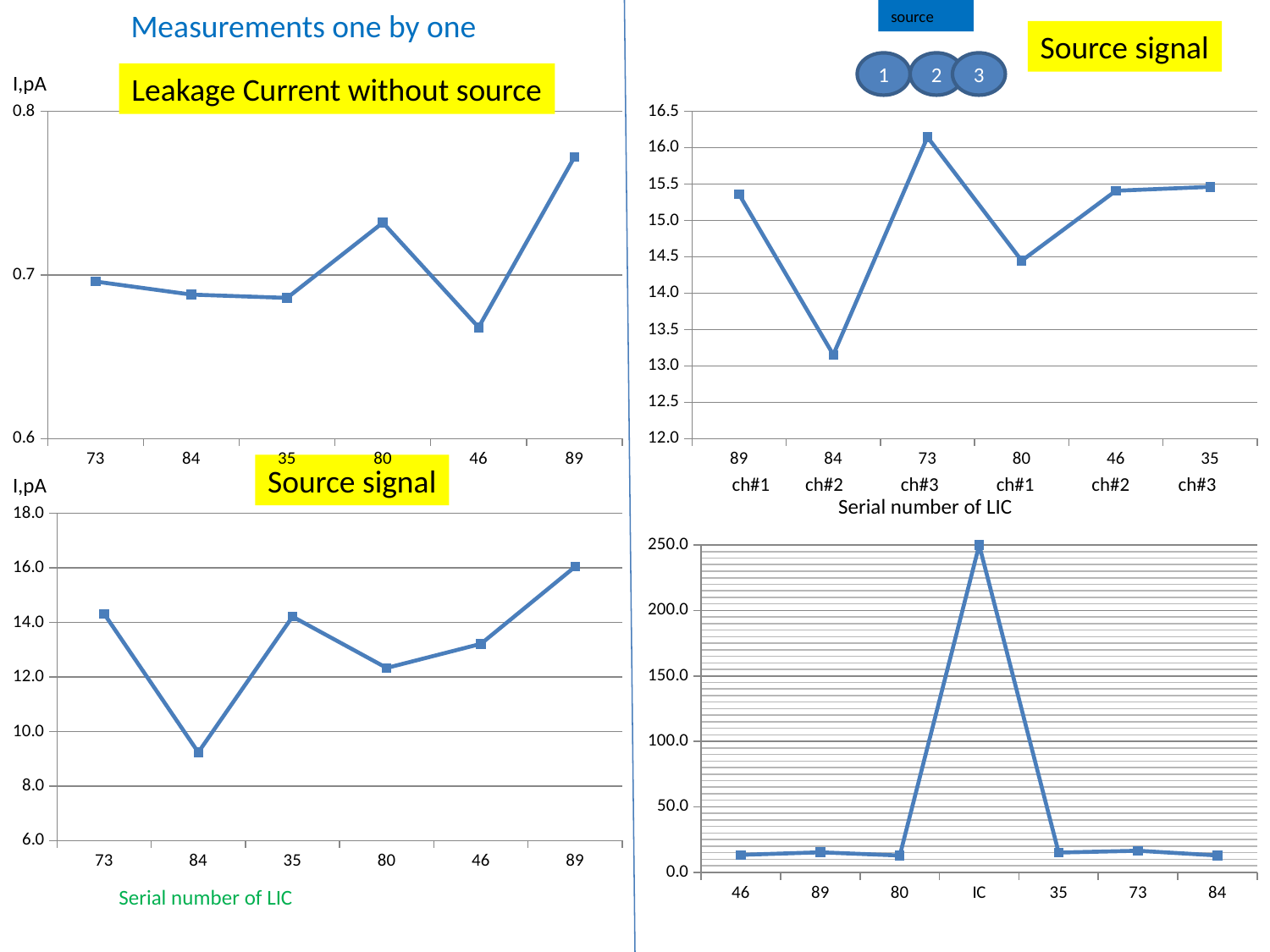
In the bottom-left 'Source signal' chart, is the value for serial number 84 greater or less than 10.0? less In the top-right 'Source signal' chart, which serial number has the highest value? 73 In the bottom-left 'Source signal' chart, which serial number has the highest value? 89 In the top-right 'Source signal' chart, is the value for serial number 84 greater or less than 13.5? less How many categories are plotted on the x axis of the bottom-right chart? 7 In the bottom-right chart, which category has the highest value? IC In the 'Leakage Current without source' chart (top left), is the value for serial number 80 greater or less than 0.7? greater What kind of chart is the 'Leakage Current without source' chart (top left)? line chart In the 'Leakage Current without source' chart (top left), which serial number has the lowest leakage current? 46 In the bottom-left 'Source signal' chart, which serial number has the lowest value? 84 How many serial numbers are plotted in the 'Leakage Current without source' chart (top left)? 6